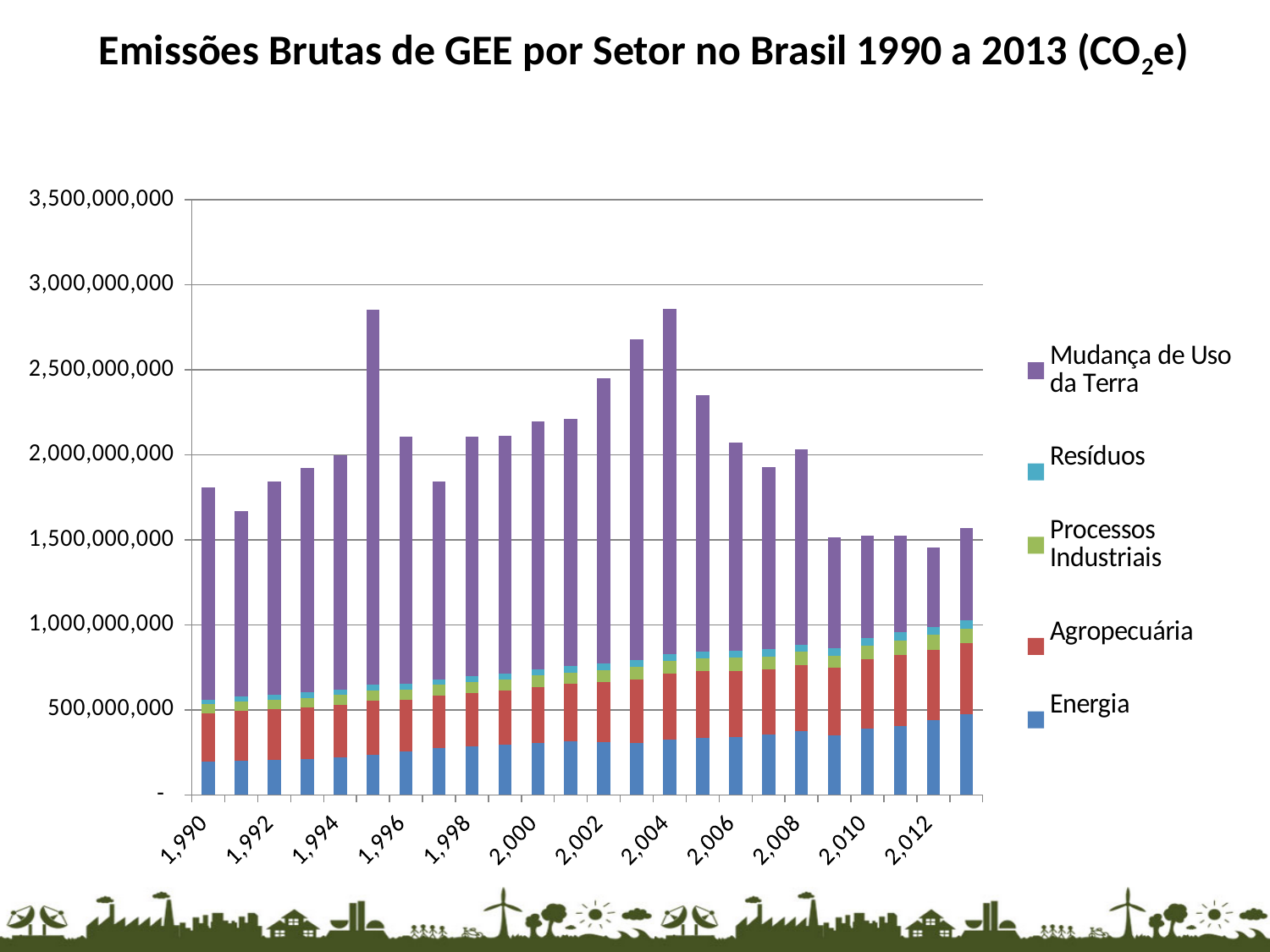
Does the Energia segment rise or fall from 1990 to 2013? rise Is the total emissions bar for 1990 greater or less than 2,000,000,000? less Which year has the taller total bar, 1995 or 1996? 1995 Which series is shown in purple? Mudança de Uso da Terra Is the total emissions bar for 2012 greater or less than 1,500,000,000? less Which year has the taller total bar, 2004 or 2005? 2004 Is the Energia segment for 1990 greater or less than 500,000,000? less How many series does the legend list? 5 What kind of chart is shown on the slide? Stacked bar chart Which series accounts for the largest share of each bar? Mudança de Uso da Terra How many years (bars) are plotted in the chart? 24